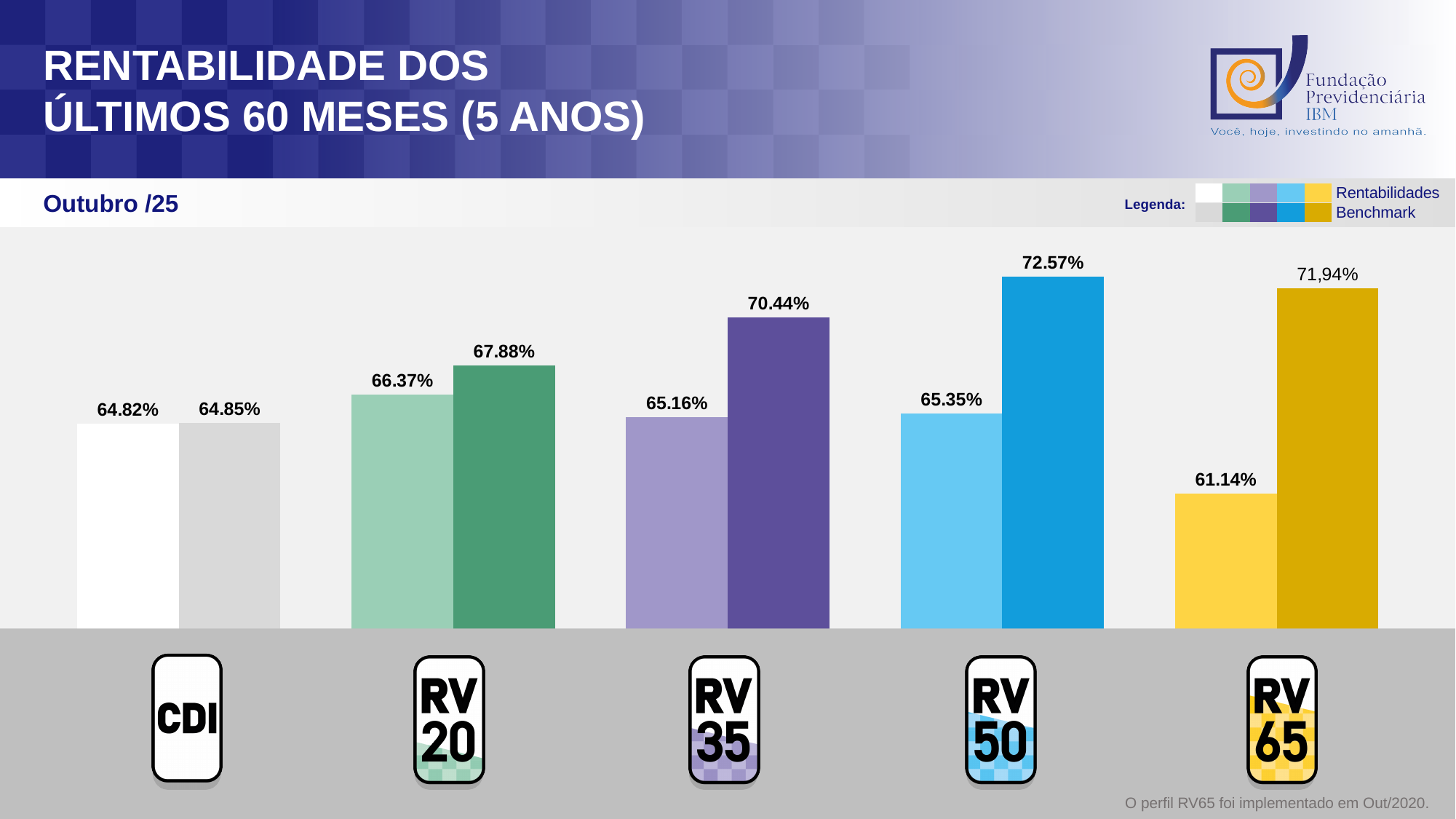
What is the difference between the Benchmark and Rentabilidades values for RV 35? 5.28% What is the Rentabilidades value for RV 20? 66.37% Which category has the lowest Rentabilidades value? RV 65 What kind of chart is shown on the slide? Bar chart What is the Benchmark value for RV 50? 72.57% Which is larger for RV 65: the Rentabilidades value or the Benchmark value? Benchmark Which category has the highest Benchmark value? RV 50 What month and year does the chart refer to, as shown on the slide? Outubro /25 How many categories are shown on the x axis of the chart? 5 What is the Rentabilidades value for CDI? 64.82% What is the Benchmark value for RV 65? 71,94% How many series does the legend list? 2